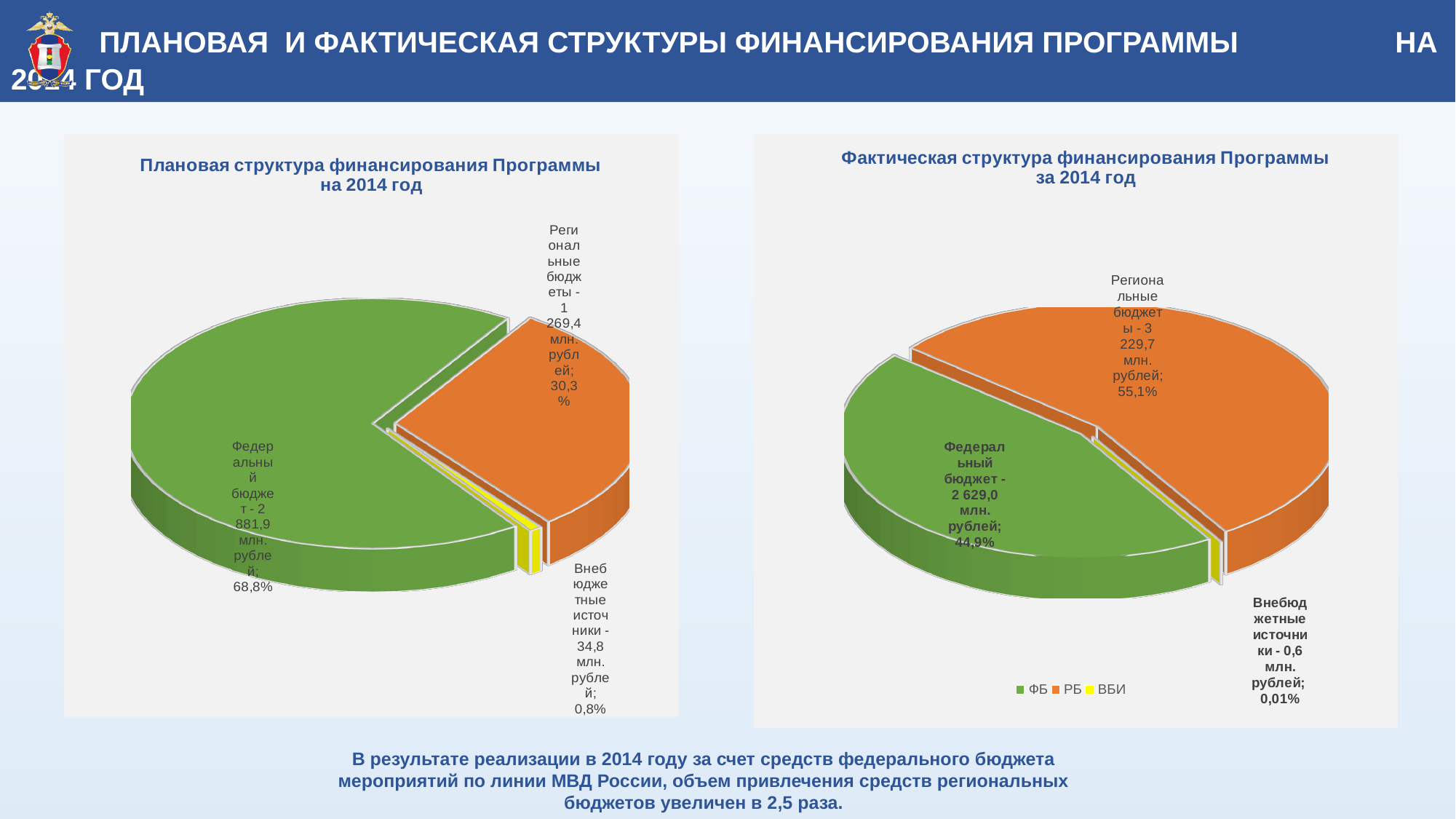
In the left chart (Плановая структура финансирования Программы на 2014 год), which category has the largest slice? Федеральный бюджет In the right chart (Фактическая структура финансирования Программы за 2014 год), what is the value for Федеральный бюджет? 2 629,0 млн. рублей In the right chart (Фактическая структура финансирования Программы за 2014 год), which is larger: Региональные бюджеты or Федеральный бюджет? Региональные бюджеты In the left chart (Плановая структура финансирования Программы на 2014 год), what share of the pie is Федеральный бюджет? 68,8% In the right chart (Фактическая структура финансирования Программы за 2014 год), which category has the smallest slice? Внебюджетные источники What type of chart is the right chart (Фактическая структура финансирования Программы за 2014 год)? Pie chart In the left chart (Плановая структура финансирования Программы на 2014 год), what is the value for Региональные бюджеты in млн. рублей? 1 269,4 млн. рублей In the right chart (Фактическая структура финансирования Программы за 2014 год), what share of the pie is Региональные бюджеты? 55,1% How many entries does the legend of the right chart (Фактическая структура финансирования Программы за 2014 год) list? 3 In the right chart (Фактическая структура финансирования Программы за 2014 год), what is the difference in percentage points between Региональные бюджеты and Федеральный бюджет? 10,2 How many slices does the left chart (Плановая структура финансирования Программы на 2014 год) have? 3 In the left chart (Плановая структура финансирования Программы на 2014 год), what is the value for Внебюджетные источники? 34,8 млн. рублей